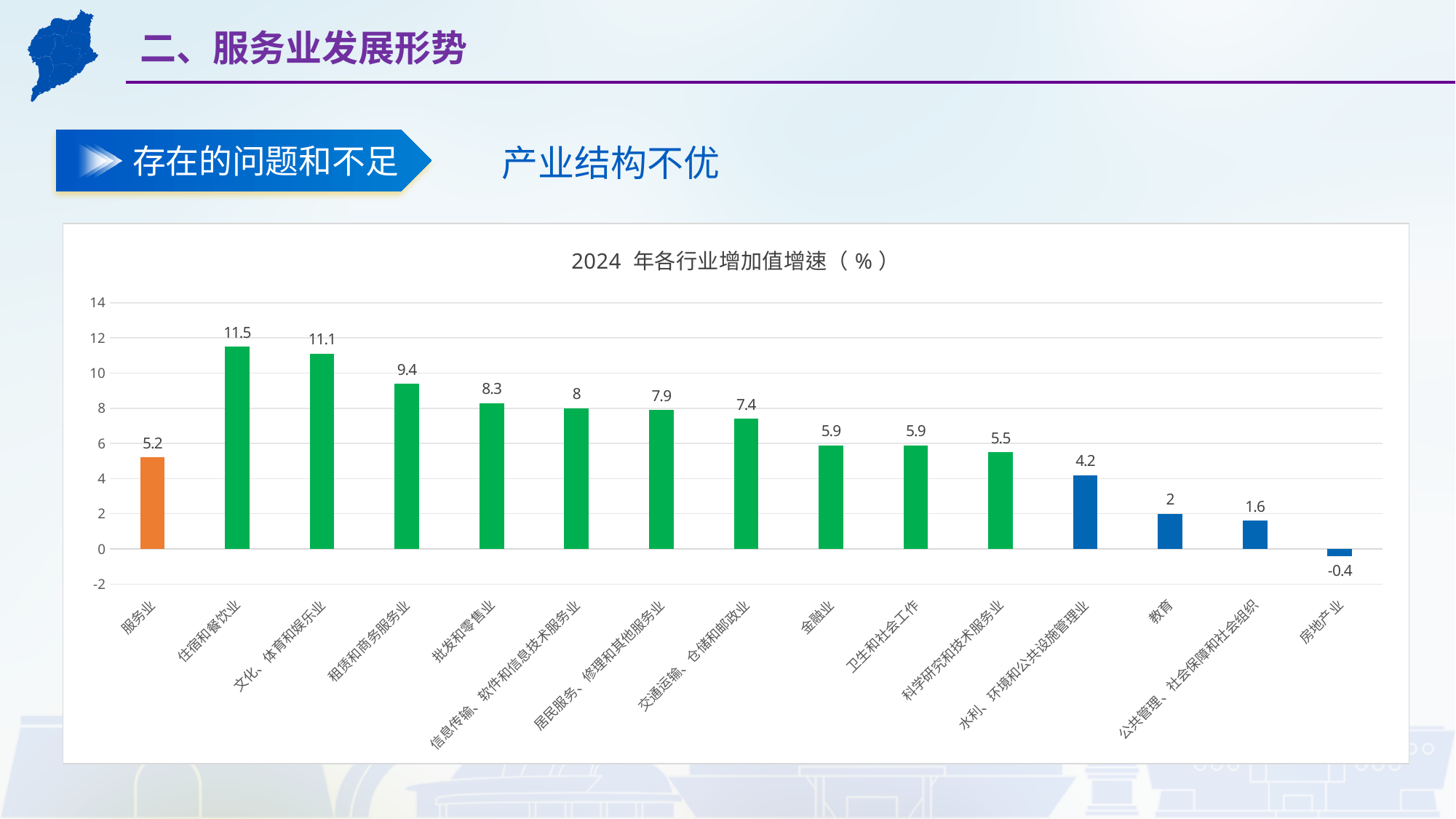
What is the value for 房地产业? -0.4 Which category has the highest value? 住宿和餐饮业 What is the value for 服务业? 5.2 Which is larger, the value for 批发和零售业 or the value for 交通运输、仓储和邮政业? 批发和零售业 How many categories are shown in the chart? 15 Is the value for 租赁和商务服务业 greater or less than 8? greater What is the difference between the values for 住宿和餐饮业 and 文化、体育和娱乐业? 0.4 What is the value for 教育? 2 Which category has the lowest value? 房地产业 What kind of chart is shown on the slide? bar chart What is the value for 住宿和餐饮业? 11.5 What is the title of the chart? 2024 年各行业增加值增速（%）